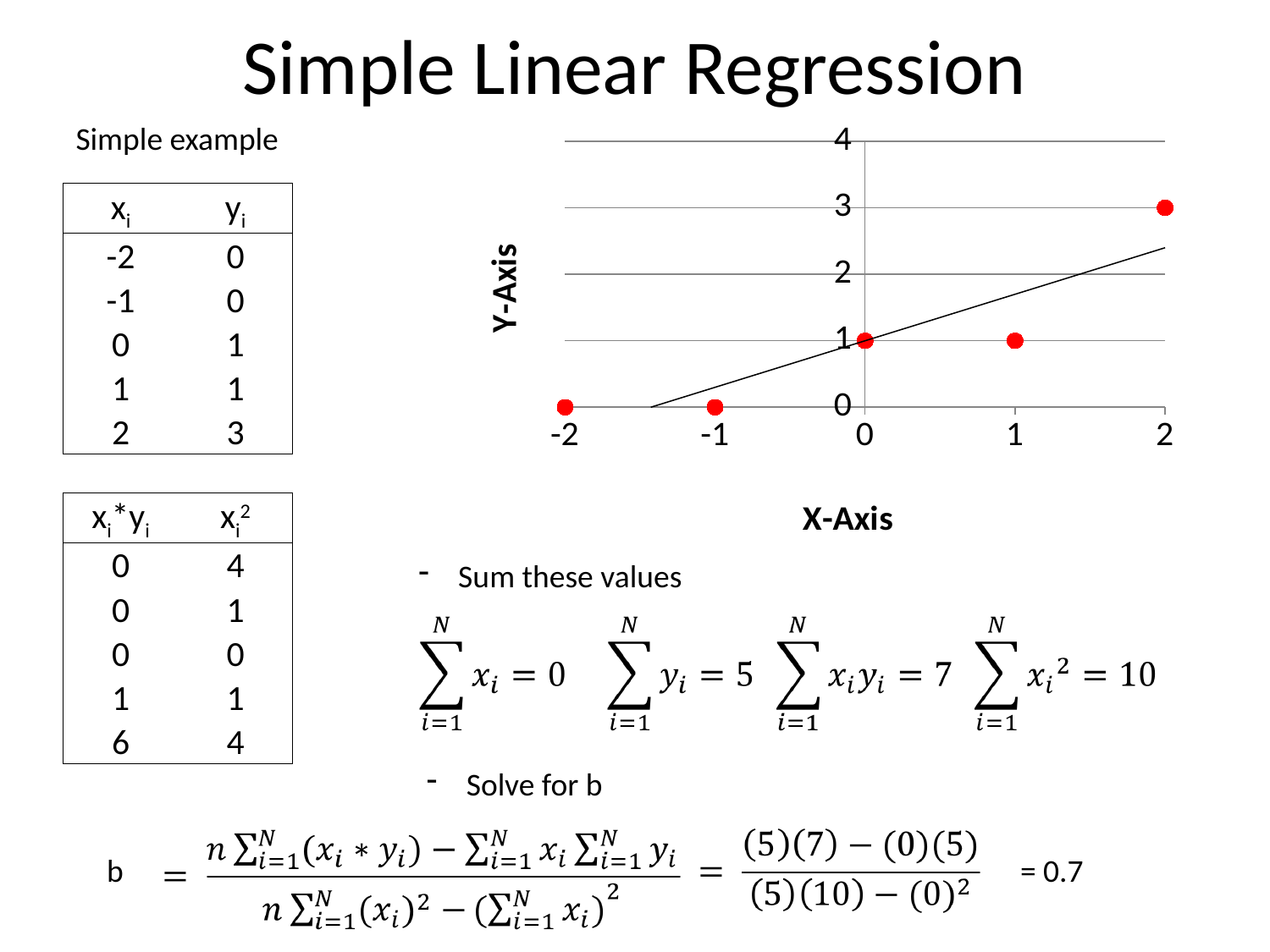
How many data points are plotted on the chart? 5 What is the title of the horizontal axis of the chart? X-Axis What is the y value of the point at x = 2? 3 What kind of chart is shown on the slide? scatter plot Is the y value of the point at x = 2 greater or less than 2? greater What is the title of the vertical axis of the chart? Y-Axis Which point has the larger y value, the one at x = 1 or the one at x = -1? x = 1 Do the plotted y values generally rise or fall as x increases? rise At which x value is the plotted point highest? 2 What is the difference between the y values at x = 2 and x = 1? 2 What is the y value of the point at x = 0? 1 What is the y value of the point at x = -2? 0